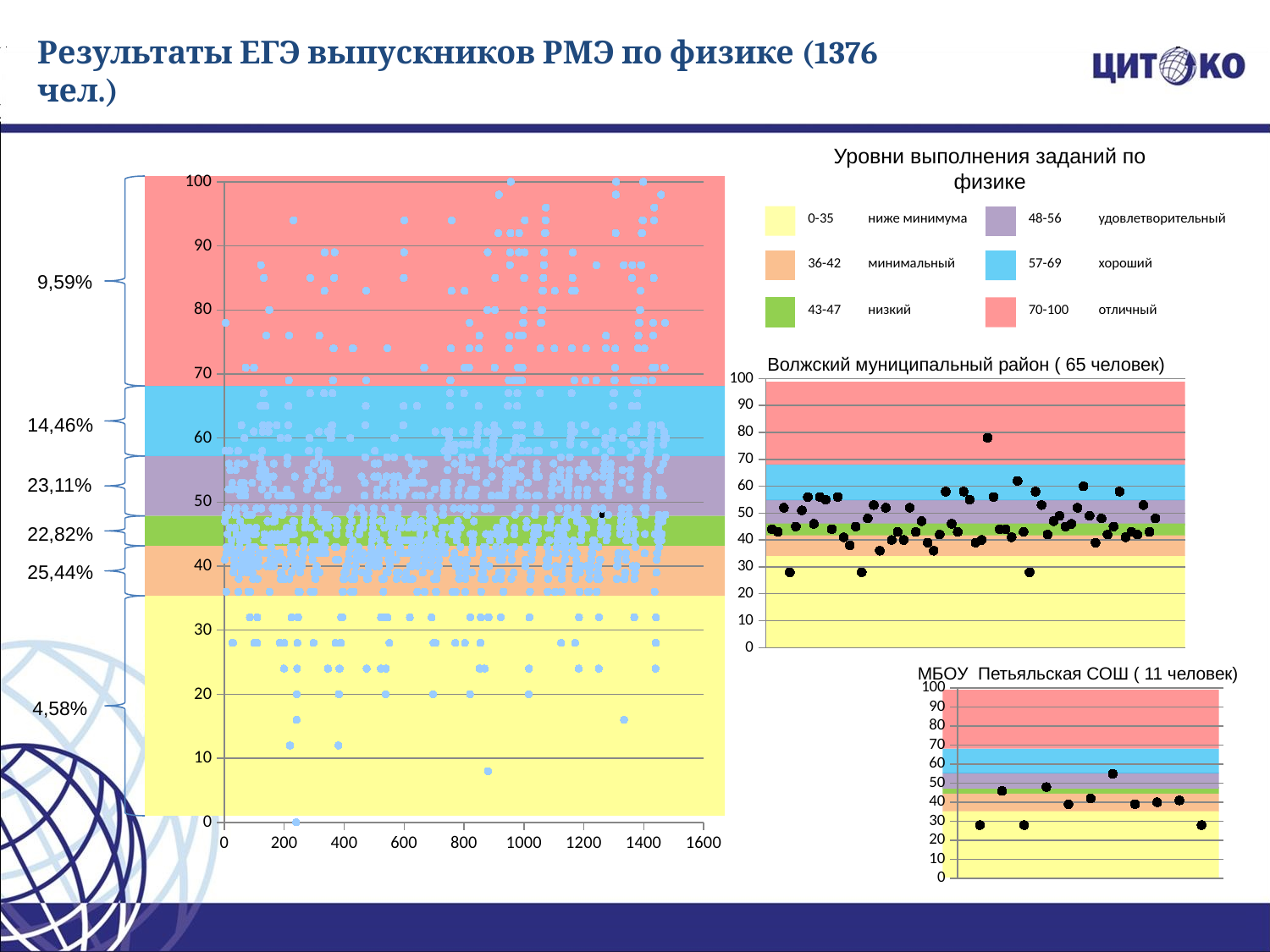
On the large chart on the left, what percentage is shown for the blue band (57-69)? 14,46% According to its title, how many people are plotted in the chart 'МБОУ Петьяльская СОШ'? 11 What kind of chart is the large chart on the left of the slide? scatter chart On the large chart on the left, which percentage label is the largest? 25,44% In the legend 'Уровни выполнения заданий по физике', which score range corresponds to the level 'отличный'? 70-100 On the large chart on the left, which percentage label is the smallest? 4,58% In the chart 'МБОУ Петьяльская СОШ', is the highest plotted point greater or less than 50? greater On the large chart on the left, what percentage is shown for the red band (70-100)? 9,59% On the large chart on the left, what is the highest value shown on the x axis? 1600 In the chart 'Волжский муниципальный район', is the highest plotted point greater or less than 70? greater On the large chart on the left, is the percentage for the purple band (23,11%) larger or smaller than the percentage for the green band (22,82%)? larger According to its title, how many people are plotted in the chart 'Волжский муниципальный район'? 65